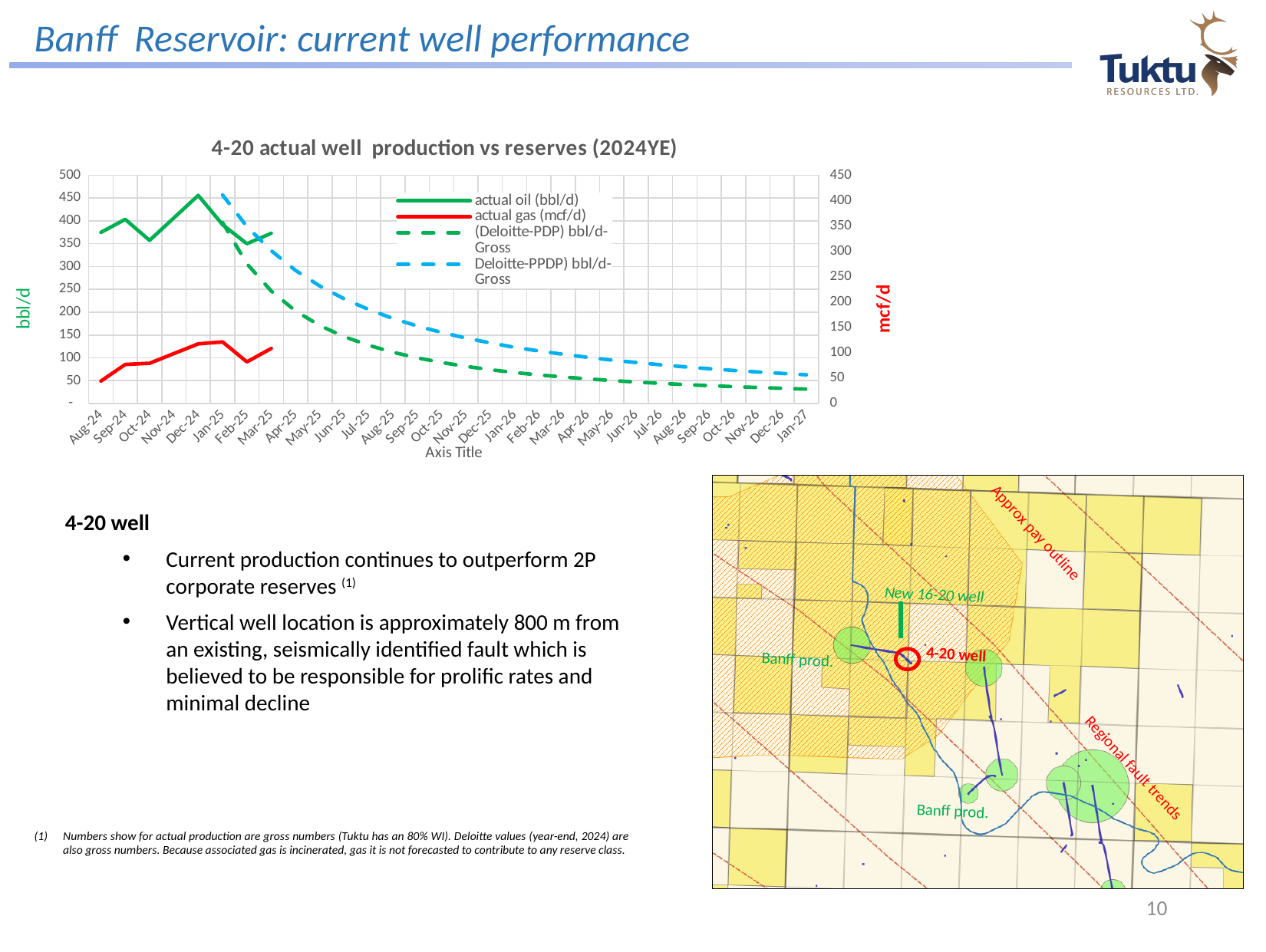
Which is larger for the actual oil (bbl/d) series: the value for Dec-24 or the value for Oct-24? Dec-24 Is the (Deloitte-PDP) bbl/d-Gross value for Jan-27 greater or less than 50? less Is the actual oil (bbl/d) value for Dec-24 greater or less than 400? greater What is the title of the chart? 4-20 actual well production vs reserves (2024YE) Does the (Deloitte-PPDP) bbl/d-Gross series rise or fall from Jan-25 to Jan-27? fall In which month is the actual gas (mcf/d) series at its lowest value? Aug-24 Is the actual gas (mcf/d) value for Aug-24 greater or less than 100? less What is the label on the left vertical axis of the chart? bbl/d In which month does the actual oil (bbl/d) series reach its highest value? Dec-24 How many series does the chart legend list? 4 How many months are labelled along the x axis of the chart? 30 What kind of chart is shown on the slide? line chart